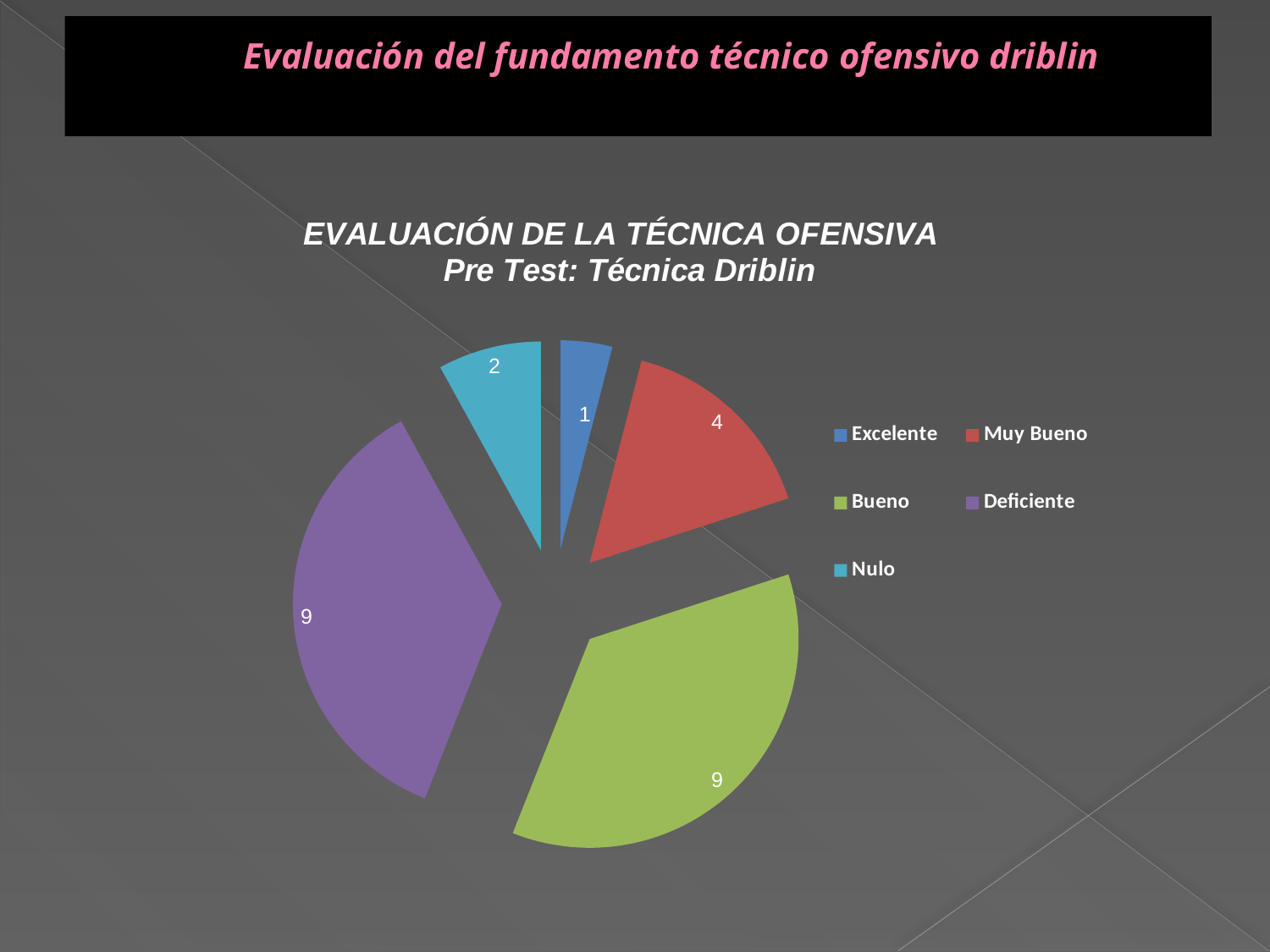
What is the difference between the values for Muy Bueno and Nulo? 2 What kind of chart is shown on the slide? pie chart What is the value for Excelente? 1 Which category has the lowest value? Excelente What is the value for Muy Bueno? 4 What is the value for Nulo? 2 What share of the pie does Nulo represent? 8% Which is larger, the value for Muy Bueno or the value for Excelente? Muy Bueno What is the title of the chart? EVALUACIÓN DE LA TÉCNICA OFENSIVA Pre Test: Técnica Driblin How many categories does the pie chart have? 5 What is the value for Deficiente? 9 What share of the pie does Bueno represent? 36%